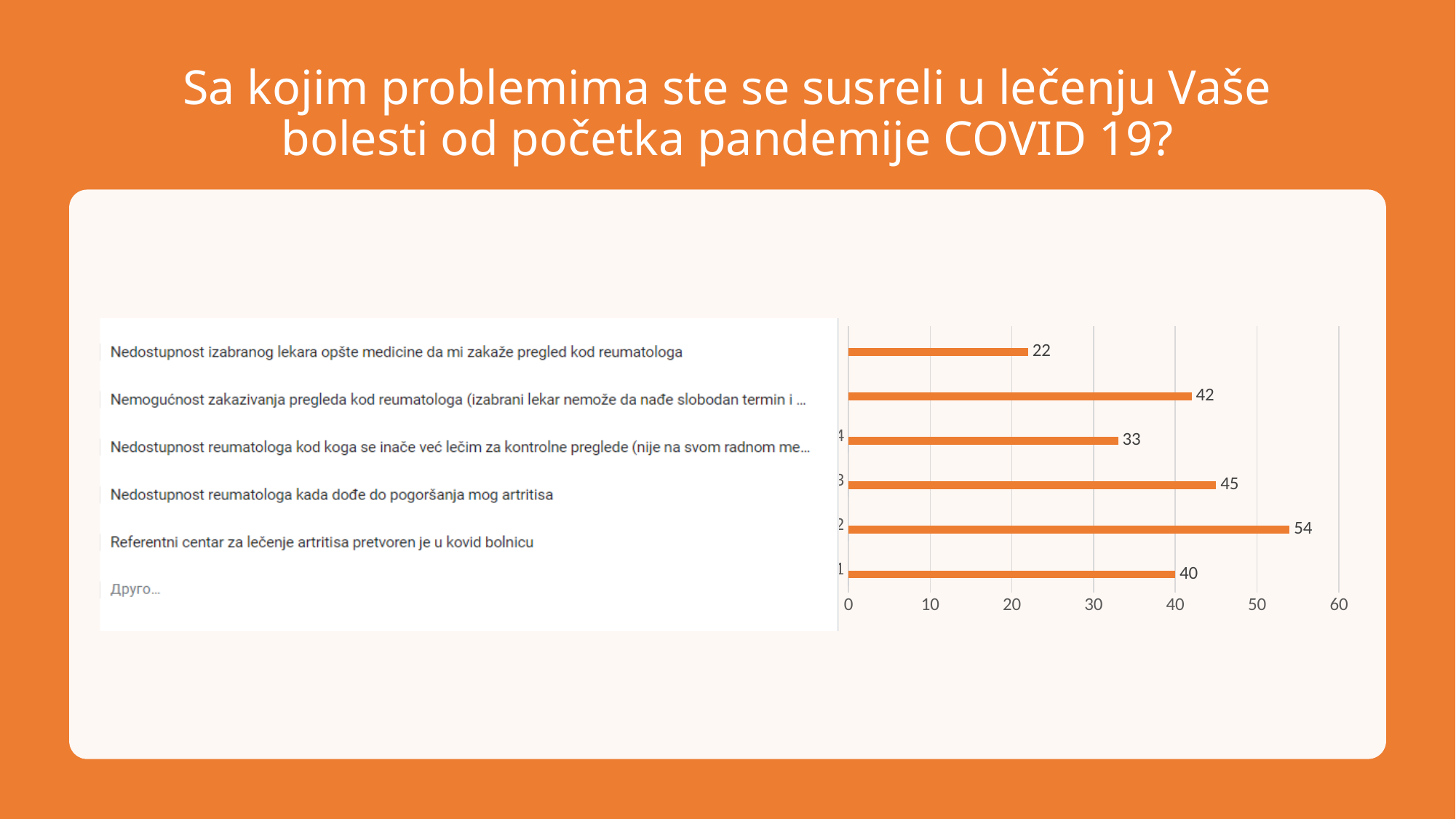
How many bars are plotted in the chart? 6 What is the maximum value shown on the horizontal axis of the chart? 60 What kind of chart is shown on the slide? bar chart Which is larger: the second bar from the top (42) or the fourth bar from the top (45)? 45 What colour are the bars in the chart? orange What is the lowest value shown in the chart? 22 Is the value of the longest bar greater or less than 50? greater What is the highest value shown in the chart? 54 What is the difference between the highest value (54) and the lowest value (22) in the chart? 32 What is the value of the bottom bar in the chart? 40 What is the value of the third bar from the top? 33 What is the value of the topmost bar in the chart? 22